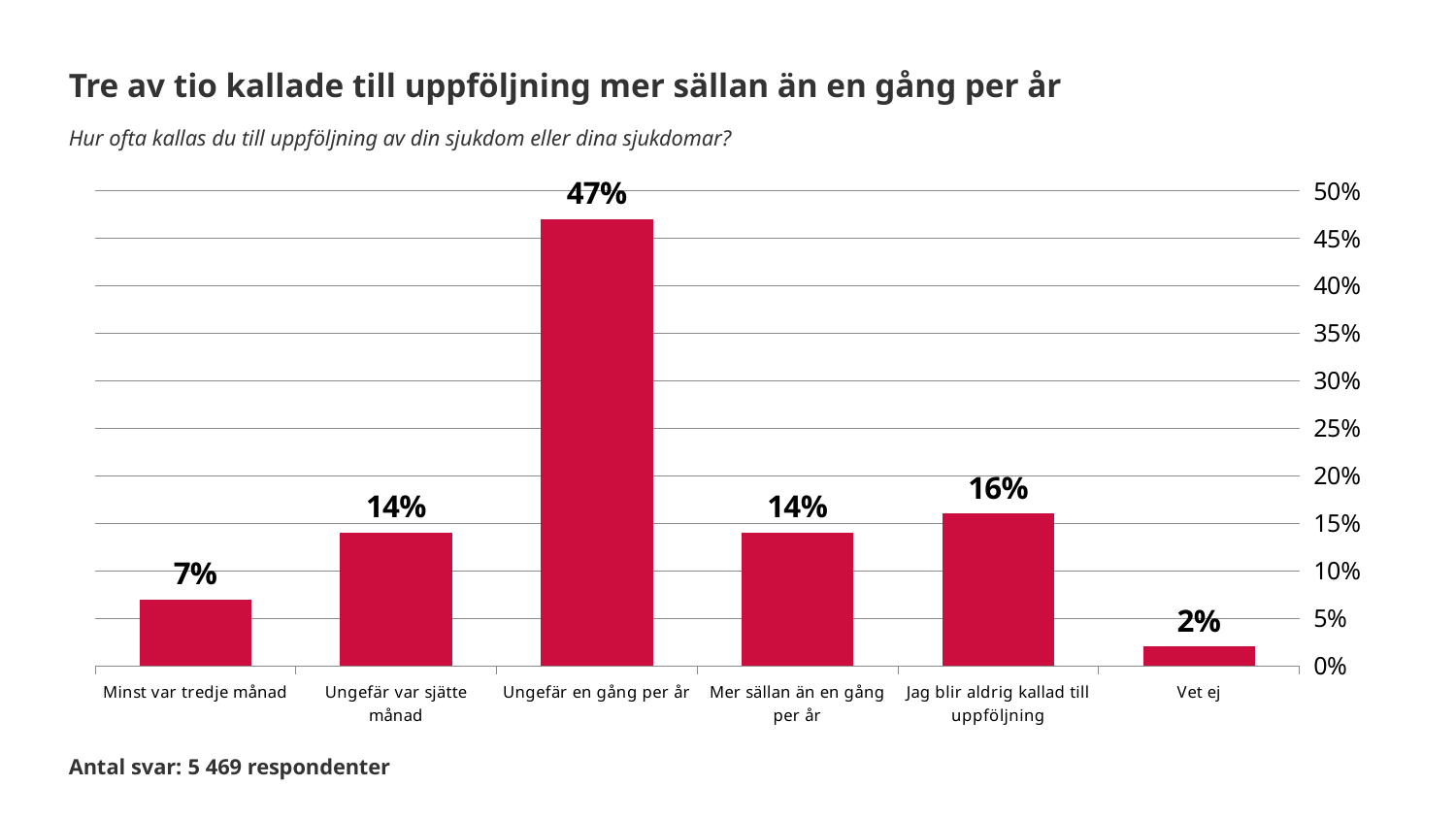
Which category has the lowest value? Vet ej Which category has the highest value? Ungefär en gång per år Which is larger, the value for "Jag blir aldrig kallad till uppföljning" or the value for "Mer sällan än en gång per år"? Jag blir aldrig kallad till uppföljning What is the value for "Vet ej"? 2% What is the value for "Jag blir aldrig kallad till uppföljning"? 16% What kind of chart is shown on the slide? bar chart Is the value for "Ungefär var sjätte månad" greater or less than 10%? greater What is the difference between the values for "Ungefär en gång per år" and "Jag blir aldrig kallad till uppföljning"? 31% What is the value for "Minst var tredje månad"? 7% How many categories are shown on the x axis? 6 What is the title of the chart on the slide? Tre av tio kallade till uppföljning mer sällan än en gång per år What is the value for "Ungefär en gång per år"? 47%